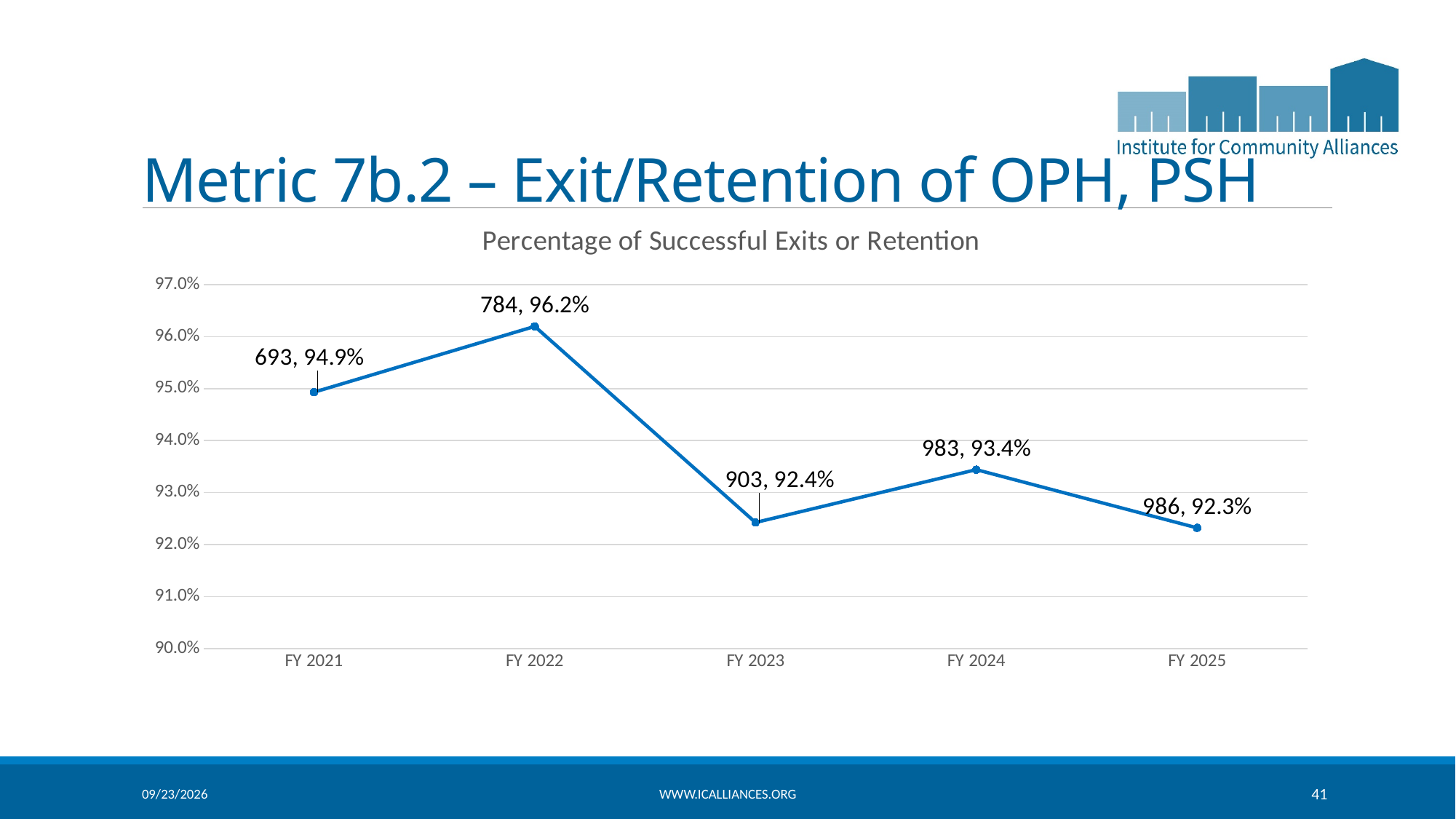
What kind of chart is shown on the slide? line chart Is the value for FY 2024 greater or less than 94.0%? less Which fiscal year has the lowest percentage of successful exits or retention? FY 2025 Which has a higher percentage, FY 2021 or FY 2024? FY 2021 What count is shown in the data label for FY 2023? 903 How many fiscal years are plotted on the chart? 5 What is the title of the chart? Percentage of Successful Exits or Retention What is the percentage of successful exits or retention for FY 2025? 92.3% Does the percentage rise or fall from FY 2024 to FY 2025? fall What is the difference in percentage points between FY 2022 and FY 2023? 3.8 Which fiscal year has the highest percentage of successful exits or retention? FY 2022 What is the percentage of successful exits or retention for FY 2022? 96.2%